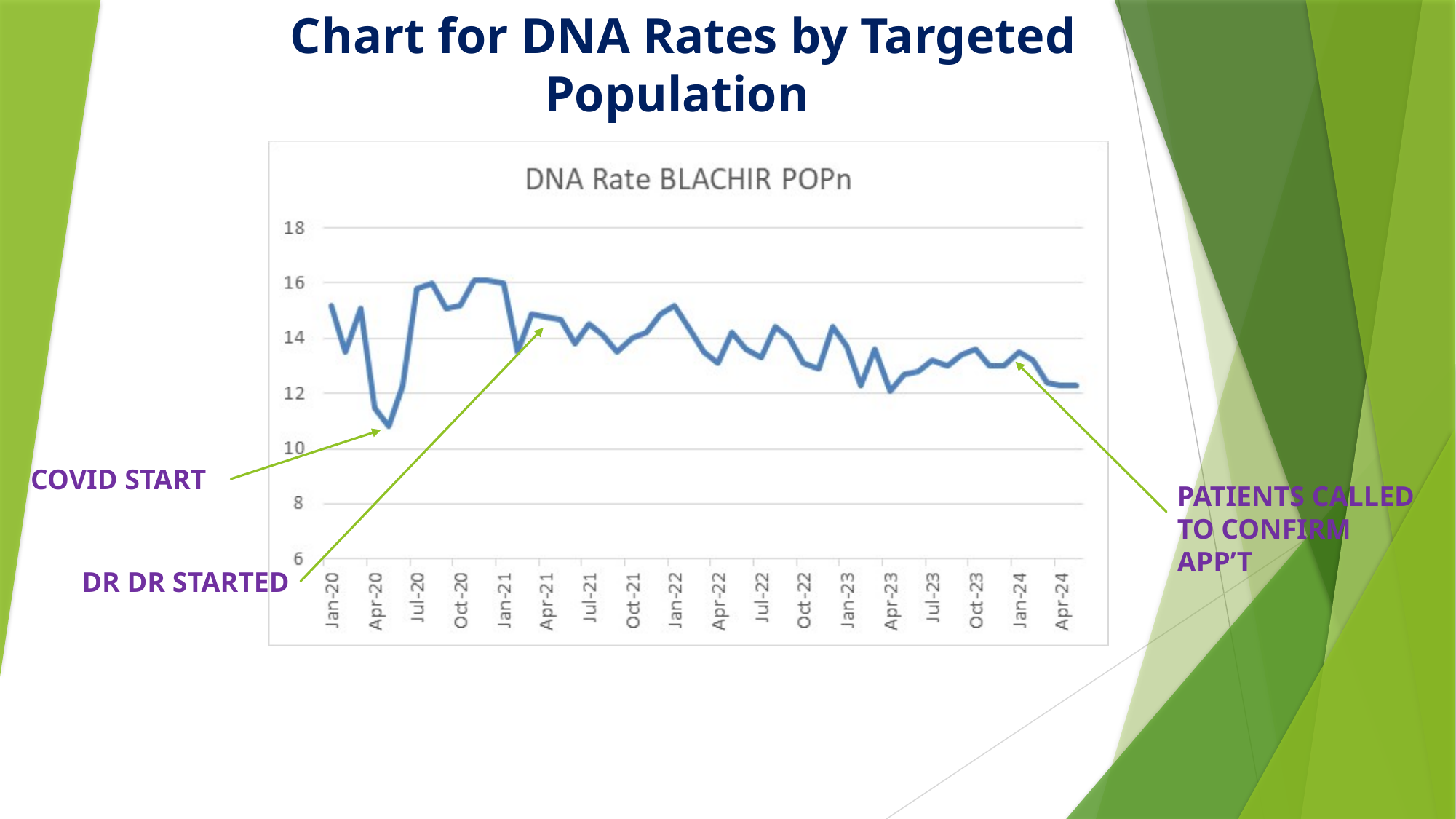
Which is larger, the value for Oct-20 or the value for Apr-23? Oct-20 Is the lowest point of the line, just after Apr-20, greater or less than 12? less What is the title printed inside the chart area? DNA Rate BLACHIR POPn Is the value for Jan-22 greater or less than 14? greater Which annotation on the slide points to the lowest point of the line? COVID START Which is larger, the value for Jan-20 or the value for Apr-24? Jan-20 How many month labels are shown along the x axis? 18 Overall, does the DNA rate rise or fall from Jan-20 to Apr-24? fall Is the value for Jan-20 greater or less than 14? greater What kind of chart is shown on the slide? line chart How many lines (data series) are plotted on the chart? 1